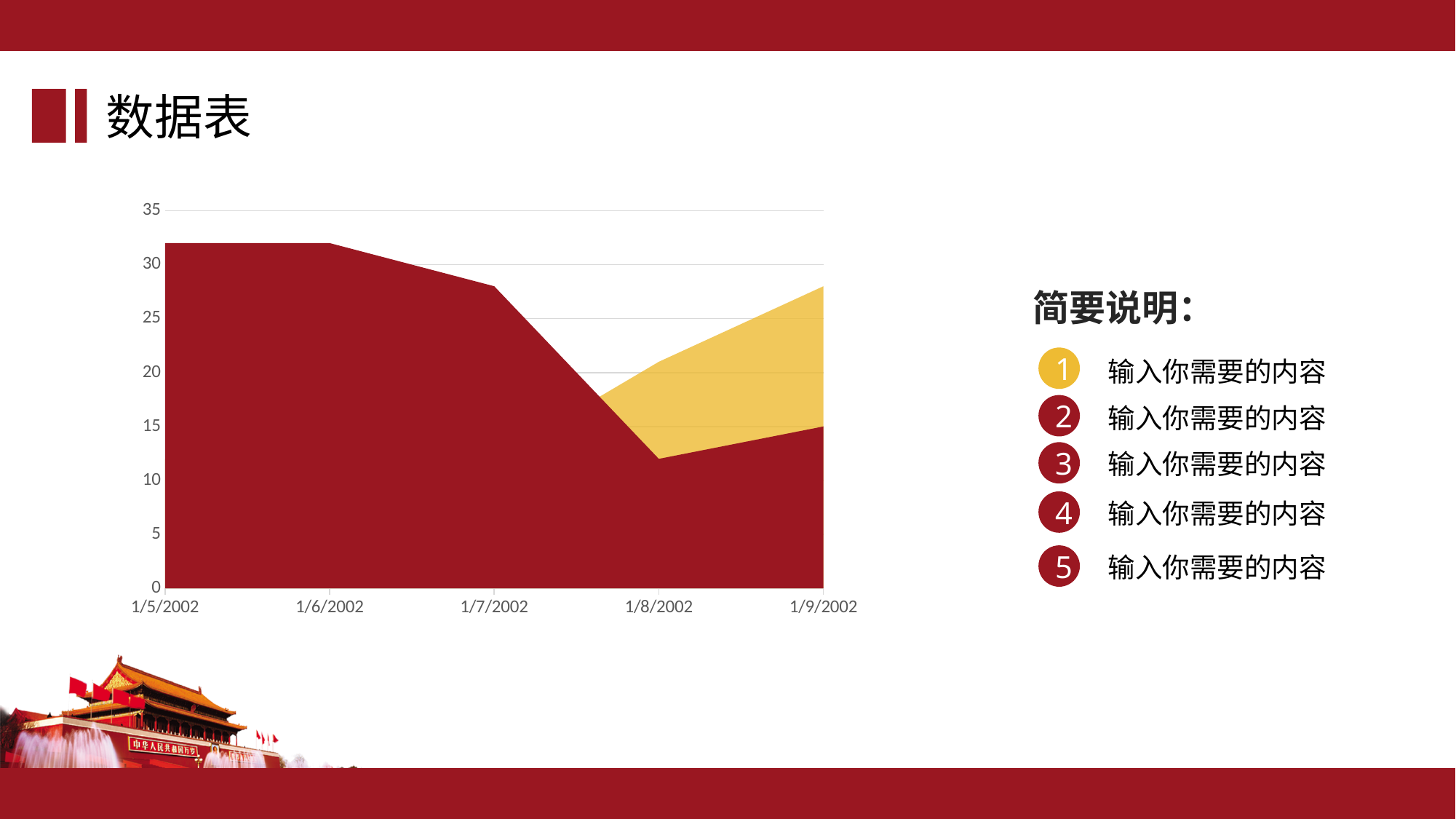
Which is larger for the red series, the value at 1/6/2002 or the value at 1/8/2002? 1/6/2002 What is the highest value shown on the y axis of the chart? 35 What kind of chart is shown on the slide? area chart Is the value of the red series at 1/8/2002 greater or less than 15? less How many dates are shown on the x axis of the chart? 5 Which is larger at 1/9/2002, the red series or the yellow series? the yellow series Is the value of the red series at 1/7/2002 greater or less than 30? less At which date does the red series reach its lowest value? 1/8/2002 Is the value of the red series at 1/5/2002 greater or less than 30? greater Does the red series rise or fall from 1/6/2002 to 1/8/2002? fall What is the first date shown on the x axis of the chart? 1/5/2002